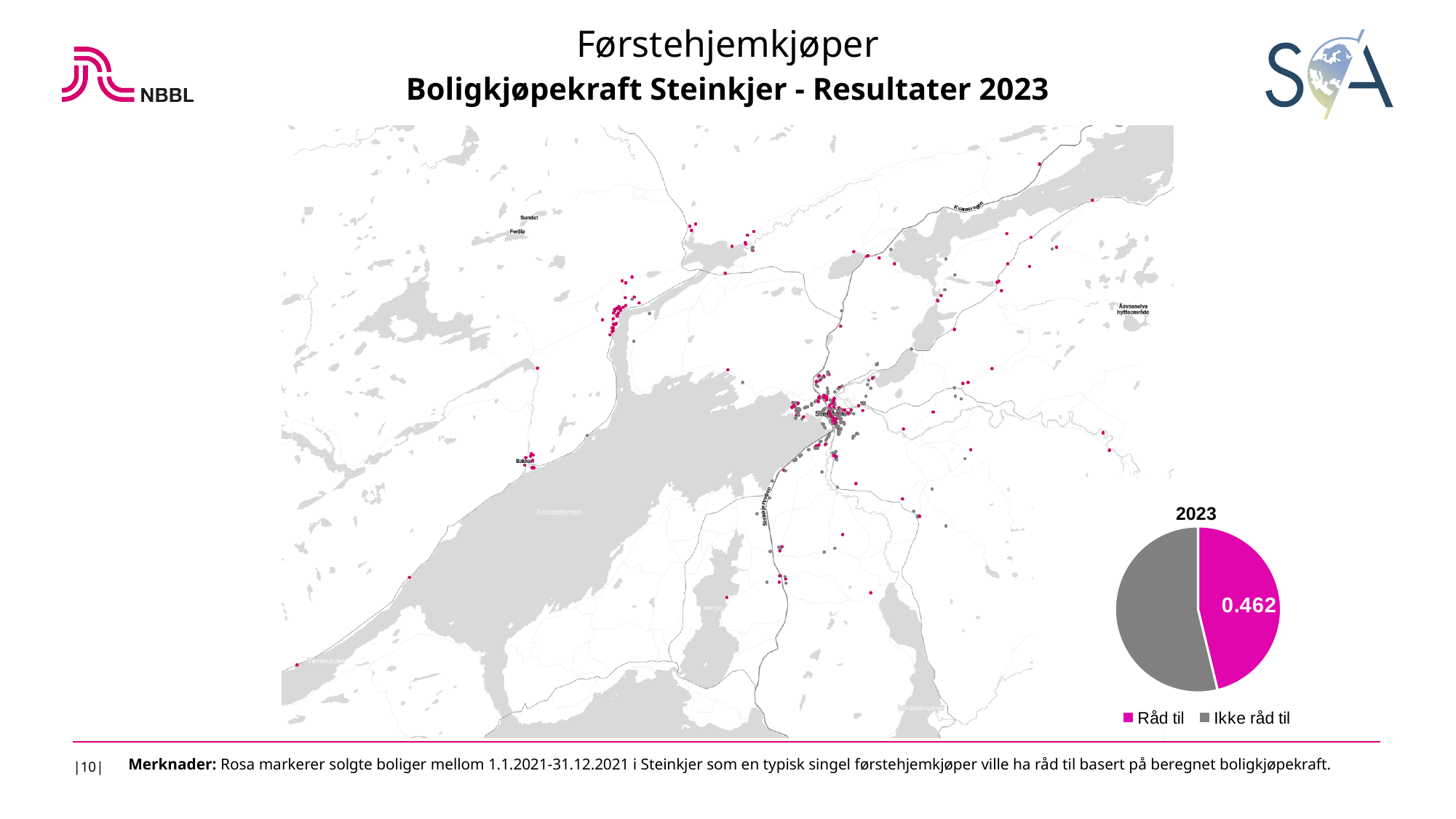
What share of the pie chart does 'Råd til' represent? 0.462 Which slice of the pie chart is larger, 'Råd til' or 'Ikke råd til'? Ikke råd til What colour is the 'Råd til' slice in the pie chart? Pink What value is printed on the 'Råd til' slice of the pie chart? 0.462 How many slices does the pie chart have? 2 What is the title of the pie chart? 2023 Which category has the largest slice in the pie chart? Ikke råd til Which category has the smallest slice in the pie chart? Råd til How many categories does the pie chart legend list? 2 What kind of chart is shown in the lower right of the slide? Pie chart